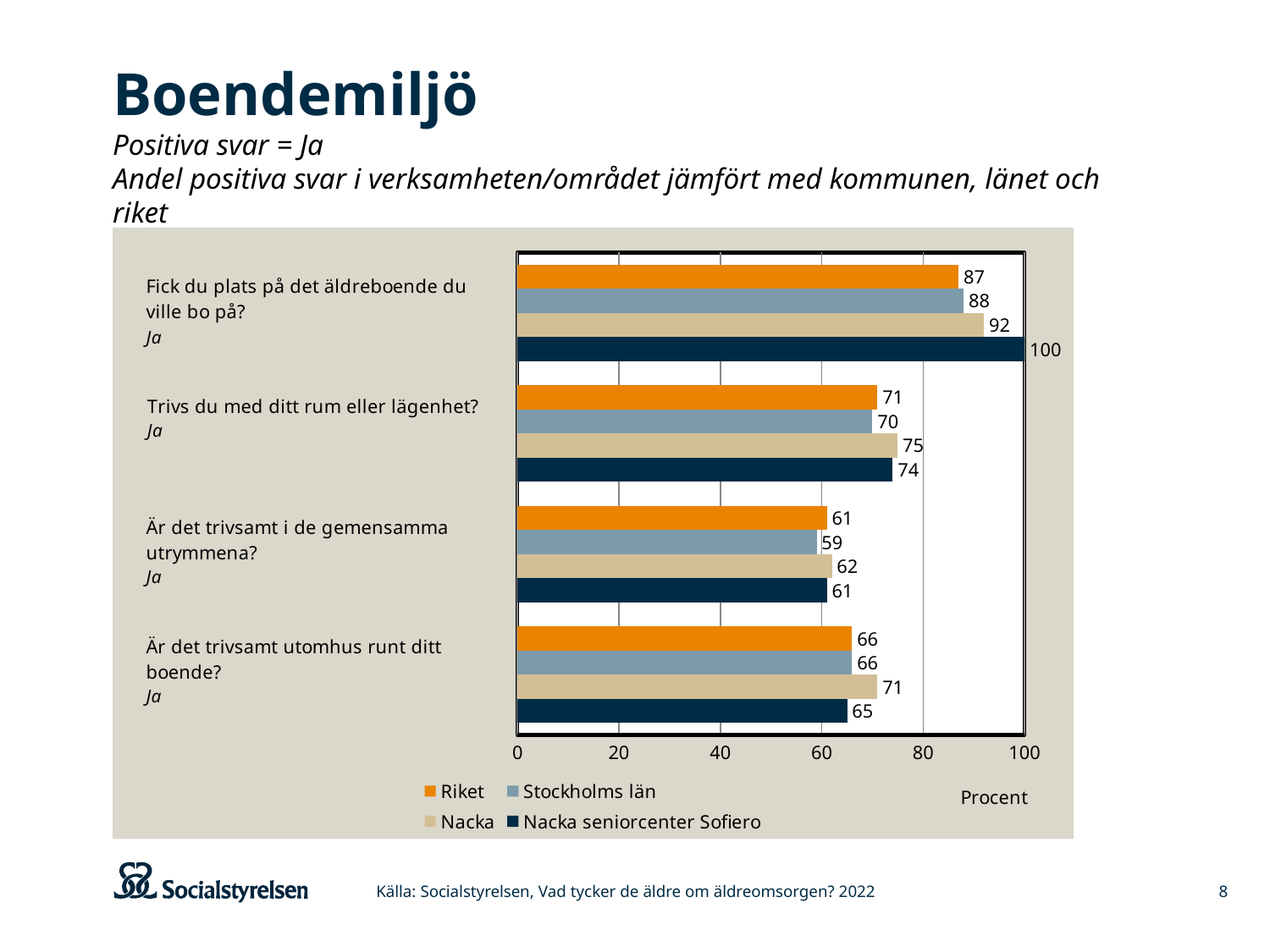
Which series has the highest value on the question "Fick du plats på det äldreboende du ville bo på?"? Nacka seniorcenter Sofiero What value is shown for Nacka on the question "Är det trivsamt utomhus runt ditt boende?"? 71 Which is larger on the question "Trivs du med ditt rum eller lägenhet?": the value for Nacka or the value for Nacka seniorcenter Sofiero? Nacka Which series has the lowest value on the question "Är det trivsamt i de gemensamma utrymmena?"? Stockholms län What value is shown for Riket on the question "Trivs du med ditt rum eller lägenhet?"? 71 How many questions (categories) are shown on the chart? 4 What value is shown for Nacka seniorcenter Sofiero on the question "Fick du plats på det äldreboende du ville bo på?"? 100 What value is shown for Stockholms län on the question "Är det trivsamt i de gemensamma utrymmena?"? 59 What kind of chart is shown on the slide? Bar chart What is the difference between the Nacka seniorcenter Sofiero value and the Riket value on the question "Fick du plats på det äldreboende du ville bo på?"? 13 How many series does the legend list? 4 What is the label on the horizontal axis of the chart? Procent